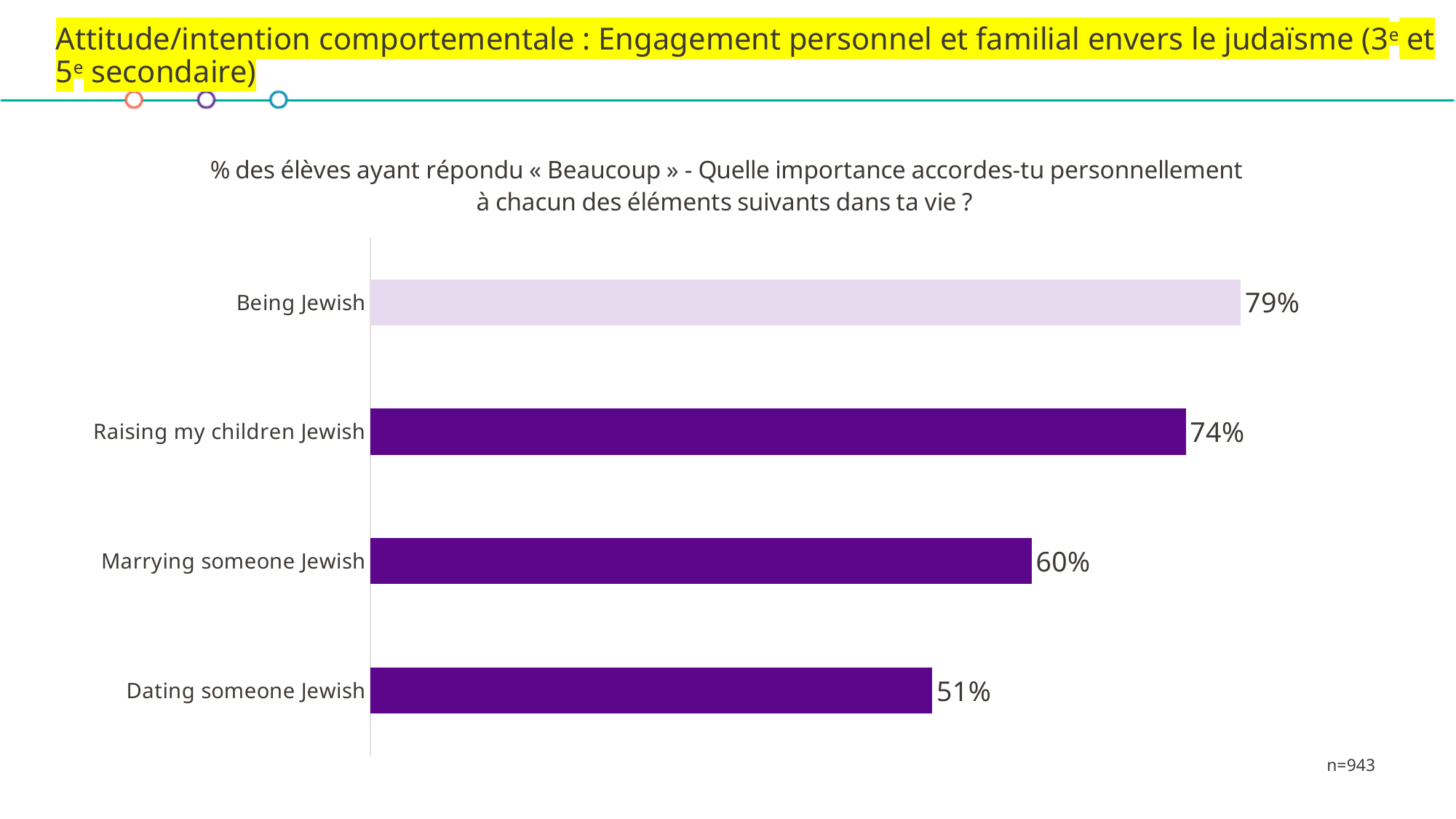
What is the value shown for Raising my children Jewish? 74% What is the difference between the values for Raising my children Jewish and Marrying someone Jewish? 14 percentage points What is the value shown for Dating someone Jewish? 51% What is the value shown for Marrying someone Jewish? 60% Which is larger, the value for Marrying someone Jewish or the value for Dating someone Jewish? Marrying someone Jewish Which category has the lowest value? Dating someone Jewish What is the sample size (n) noted on the slide? n=943 What kind of chart is shown on the slide? Bar chart What is the difference between the values for Being Jewish and Dating someone Jewish? 28 percentage points How many categories are shown in the chart? 4 Which category has the highest value? Being Jewish What percentage of students answered « Beaucoup » for Being Jewish? 79%